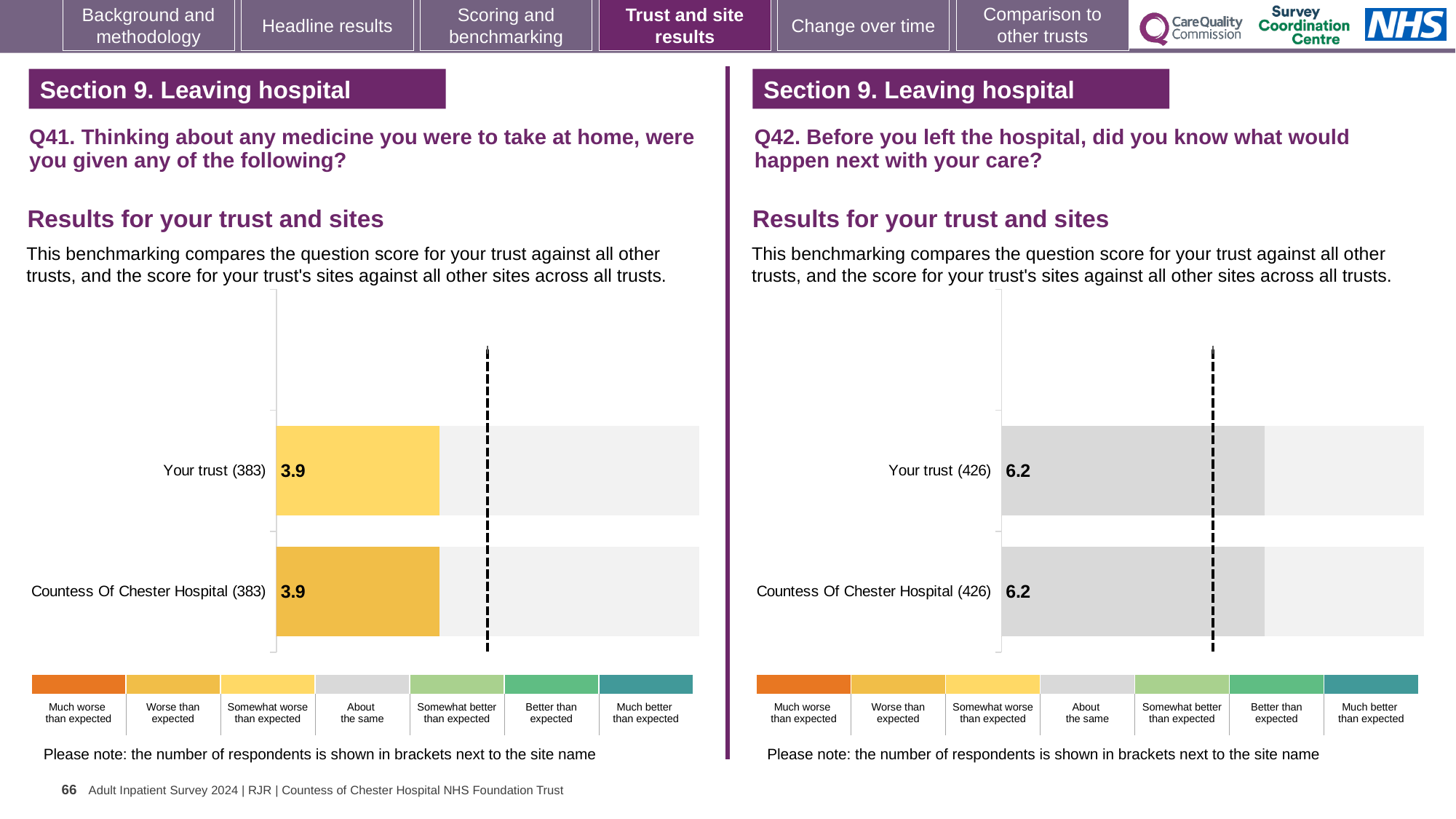
How many bars are plotted on the Q41 chart (left)? 2 On the Q41 chart (left), how many respondents are shown in brackets next to Your trust? 383 On the Q42 chart (right), how many respondents are shown in brackets next to Countess Of Chester Hospital? 426 What kind of chart is used for the Q42 results (right)? Bar chart On the Q42 chart (right), what is the score for Your trust? 6.2 On the Q42 chart (right), what is the difference between the score for Your trust and the score for Countess Of Chester Hospital? 0.0 On the Q41 chart (left), what is the score for Your trust? 3.9 On the Q42 chart (right), which benchmark category does the grey colour of the bars correspond to in the legend? About the same On the Q42 chart (right), what is the score for Countess Of Chester Hospital? 6.2 On the Q41 chart (left), what is the score for Countess Of Chester Hospital? 3.9 How many bars are plotted on the Q42 chart (right)? 2 On the Q41 chart (left), what is the difference between the score for Your trust and the score for Countess Of Chester Hospital? 0.0